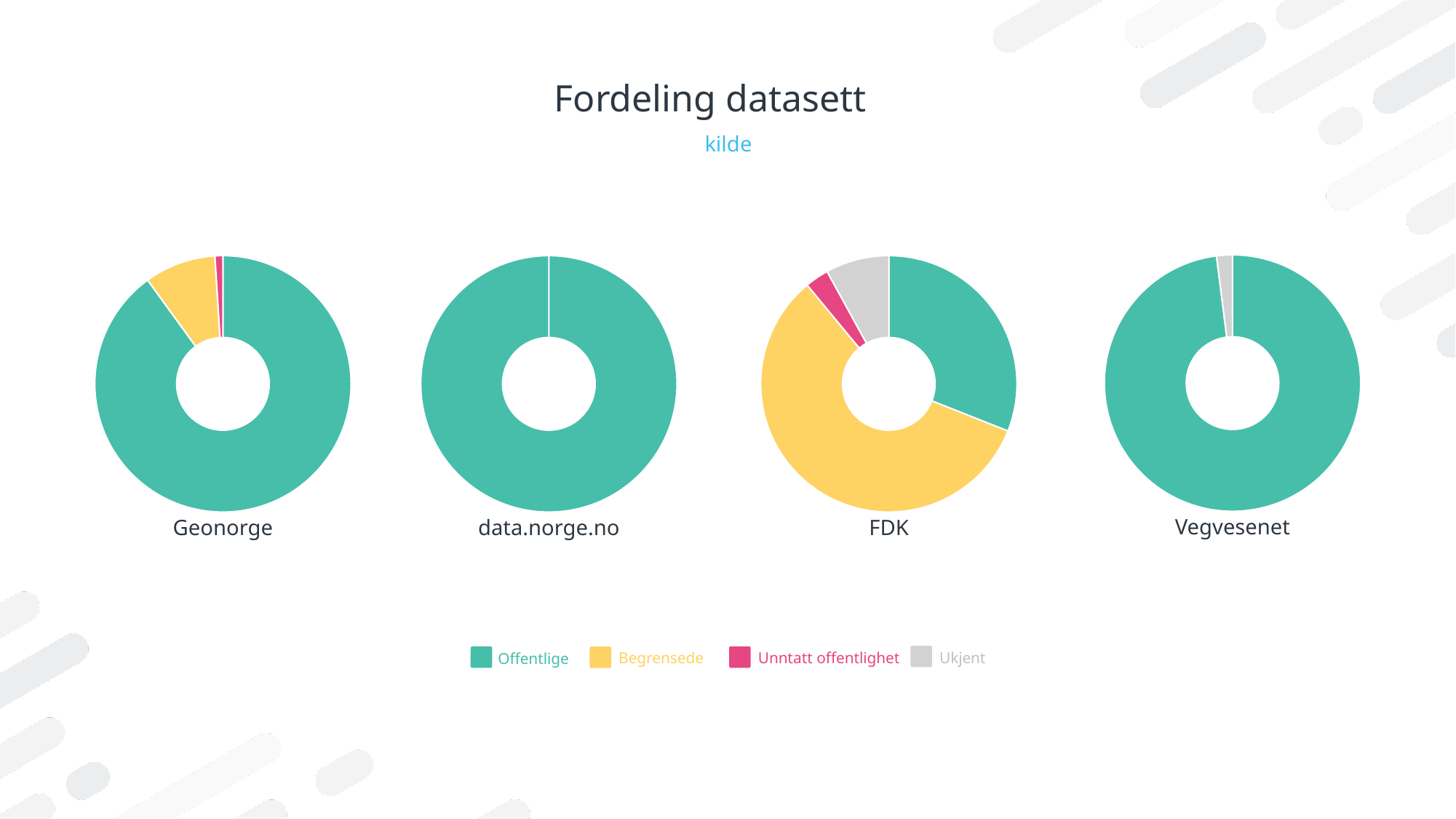
In the FDK chart, which category has the largest share? Begrensede How many charts are shown on the slide? 4 What is the title of the slide's charts? Fordeling datasett In the FDK chart, which is larger: the Begrensede share or the Offentlige share? Begrensede How many categories are visible in the Vegvesenet chart? 2 Which legend entry is shown in yellow? Begrensede In the FDK chart, which category has the smallest share? Unntatt offentlighet What kind of chart is used to show the Geonorge distribution? pie chart In the Vegvesenet chart, which is larger: the Offentlige share or the Ukjent share? Offentlige How many categories does the legend list? 4 In the Geonorge chart, which category has the smallest share? Unntatt offentlighet In the Geonorge chart, which category has the largest share? Offentlige